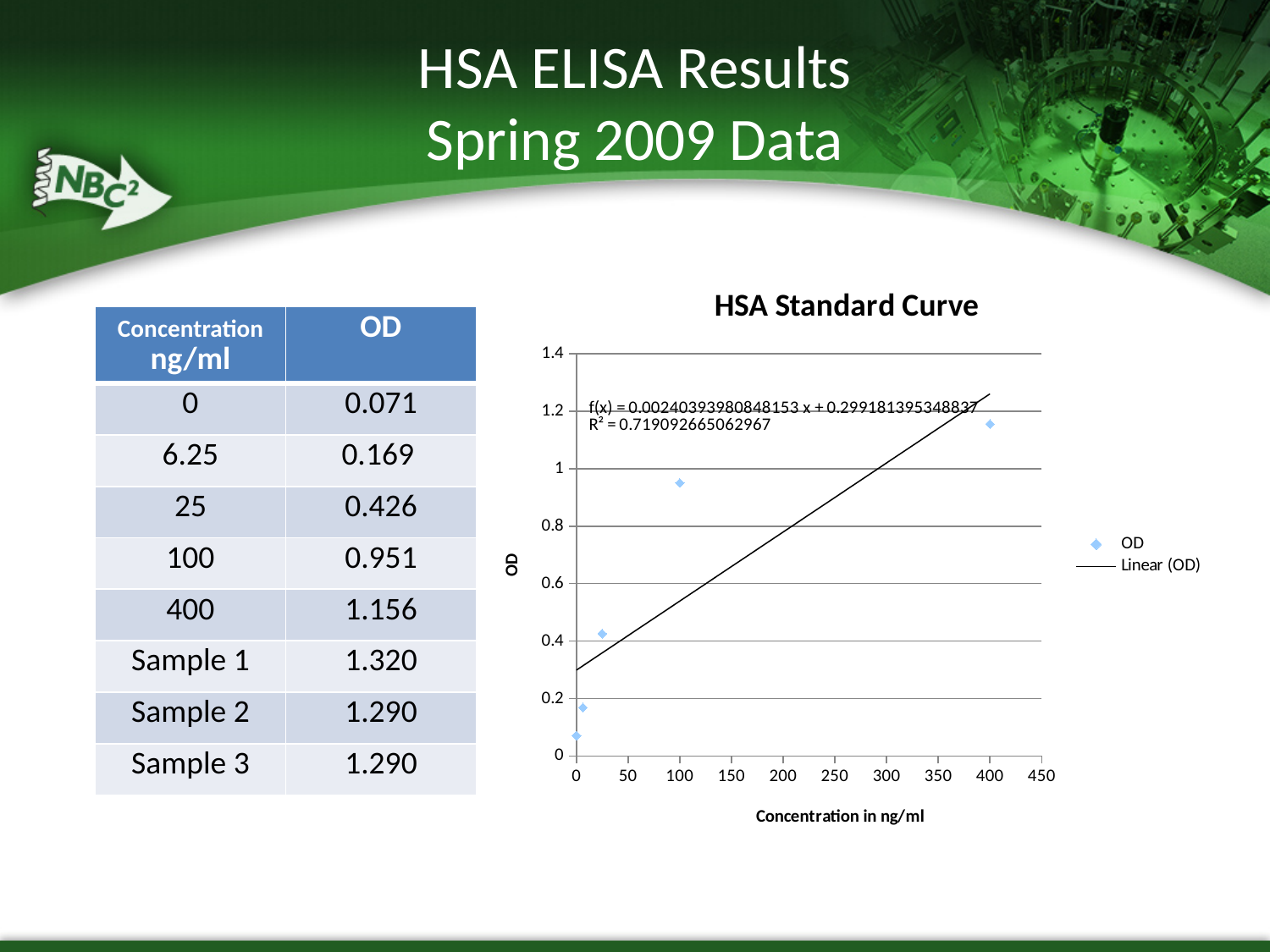
What R² value is printed on the HSA Standard Curve chart? 0.719092665062967 On the HSA Standard Curve chart, at which concentration is the OD highest? 400 What kind of chart is the HSA Standard Curve? scatter chart How many entries does the legend of the HSA Standard Curve chart list? 2 How many data points are plotted on the HSA Standard Curve chart? 5 On the HSA Standard Curve chart, does OD rise or fall as concentration increases? rise On the HSA Standard Curve chart, at which concentration is the OD lowest? 0 On the HSA Standard Curve chart, is the OD value at a concentration of 100 ng/ml greater or less than 0.8? greater On the HSA Standard Curve chart, is the OD value at a concentration of 400 ng/ml greater or less than 1? greater On the HSA Standard Curve chart, is the OD value at a concentration of 25 ng/ml greater or less than 0.6? less What is the x-axis label of the HSA Standard Curve chart? Concentration in ng/ml What is the title of the chart on the slide? HSA Standard Curve